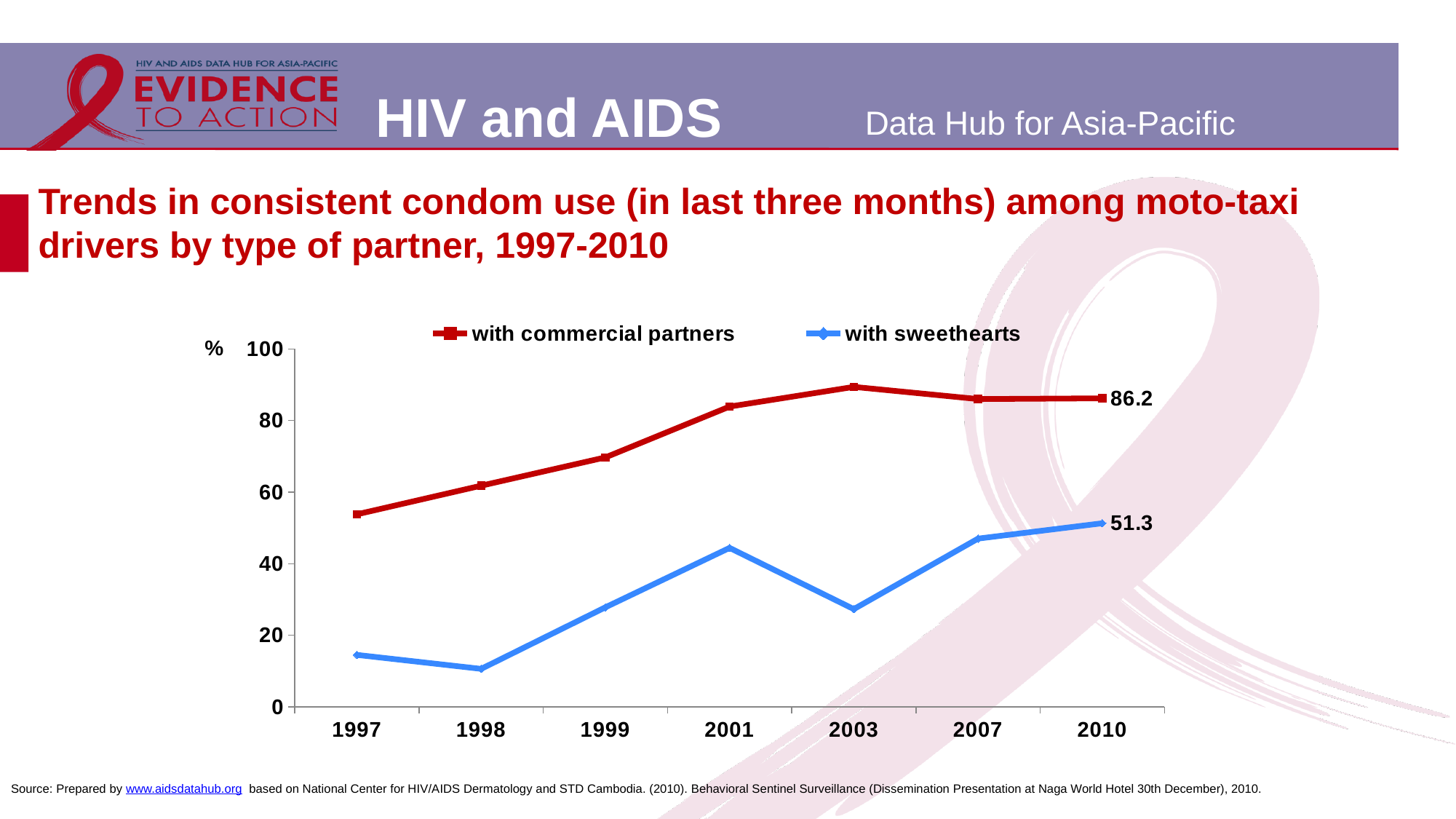
Is the value for 'with sweethearts' in 1998 greater or less than 20? less Does the 'with commercial partners' series rise or fall from 1997 to 2003? rise What kind of chart is shown on the slide? line chart How many series does the legend list? 2 How many years are shown on the x axis? 7 What is the difference between the 2010 values for 'with commercial partners' and 'with sweethearts'? 34.9 Is the value for 'with commercial partners' in 1997 greater or less than 40? greater What is the value for 'with commercial partners' in 2010? 86.2 Is the value for 'with sweethearts' in 2003 greater or less than 40? less In which year is the value for 'with commercial partners' lowest? 1997 What is the value for 'with sweethearts' in 2010? 51.3 In 2010, which series has the higher value: 'with commercial partners' or 'with sweethearts'? with commercial partners